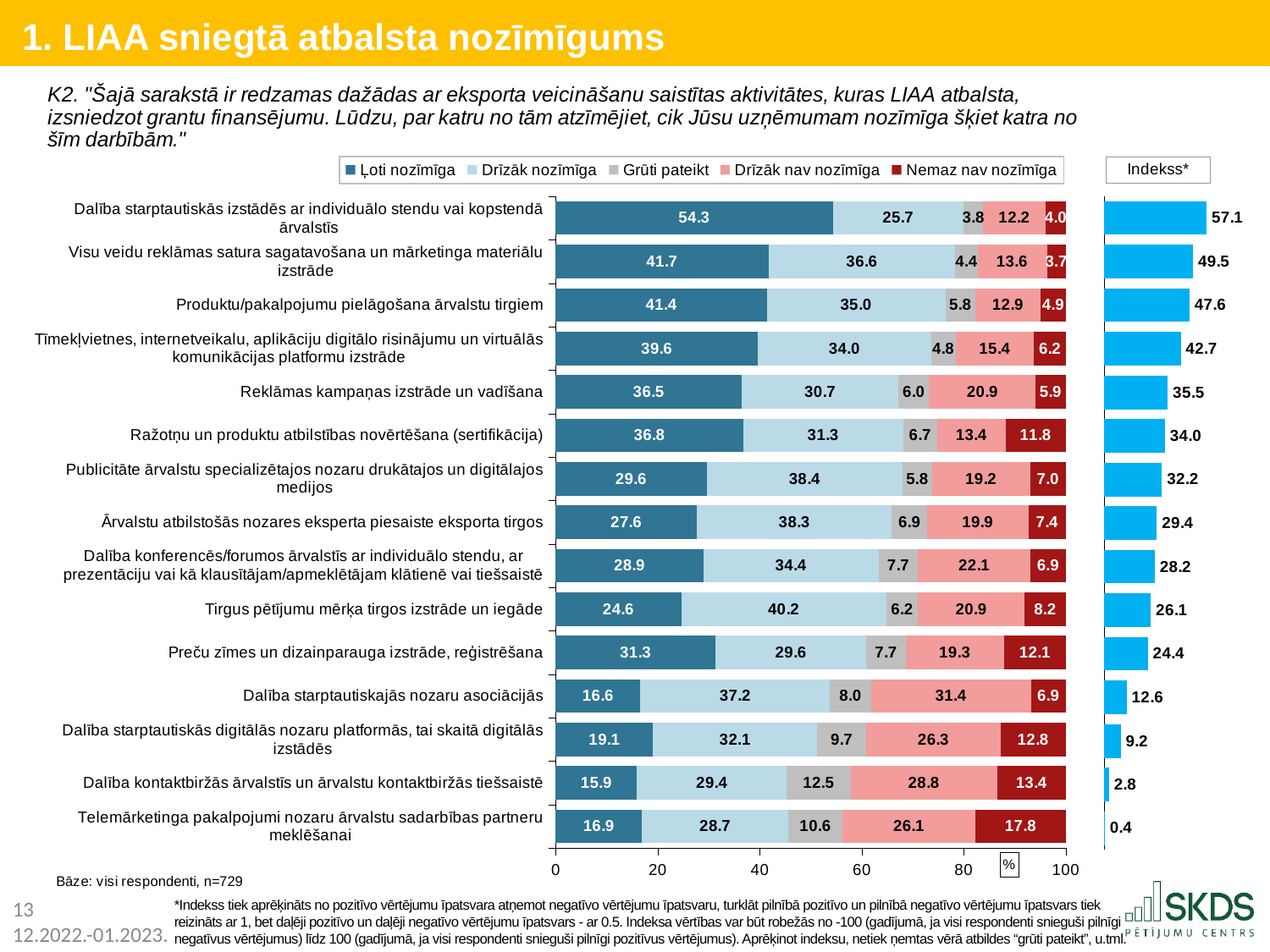
How many categories does the stacked bar chart show? 15 In the stacked bar chart, what is the 'Drīzāk nav nozīmīga' value for 'Dalība starptautiskajās nozaru asociācijās'? 31.4 How many series does the legend of the stacked bar chart list? 5 In the stacked bar chart, what is the 'Ļoti nozīmīga' value for 'Dalība starptautiskās izstādēs ar individuālo stendu vai kopstendā ārvalstīs'? 54.3 In the stacked bar chart, which category has the highest 'Ļoti nozīmīga' value? Dalība starptautiskās izstādēs ar individuālo stendu vai kopstendā ārvalstīs What kind of chart is the chart on the left of the slide? Stacked bar chart In the 'Indekss*' chart, which category has the lowest index value? Telemārketinga pakalpojumi nozaru ārvalstu sadarbības partneru meklēšanai In the 'Indekss*' chart, what is the difference between the index values for 'Visu veidu reklāmas satura sagatavošana un mārketinga materiālu izstrāde' and 'Produktu/pakalpojumu pielāgošana ārvalstu tirgiem'? 1.9 In the stacked bar chart, what is the 'Nemaz nav nozīmīga' value for 'Telemārketinga pakalpojumi nozaru ārvalstu sadarbības partneru meklēšanai'? 17.8 In the stacked bar chart, which is larger: the 'Drīzāk nozīmīga' value for 'Tirgus pētījumu mērķa tirgos izstrāde un iegāde' or for 'Preču zīmes un dizainparauga izstrāde, reģistrēšana'? Tirgus pētījumu mērķa tirgos izstrāde un iegāde In the 'Indekss*' chart, which category has the highest index value? Dalība starptautiskās izstādēs ar individuālo stendu vai kopstendā ārvalstīs In the 'Indekss*' chart, what is the index value for 'Reklāmas kampaņas izstrāde un vadīšana'? 35.5